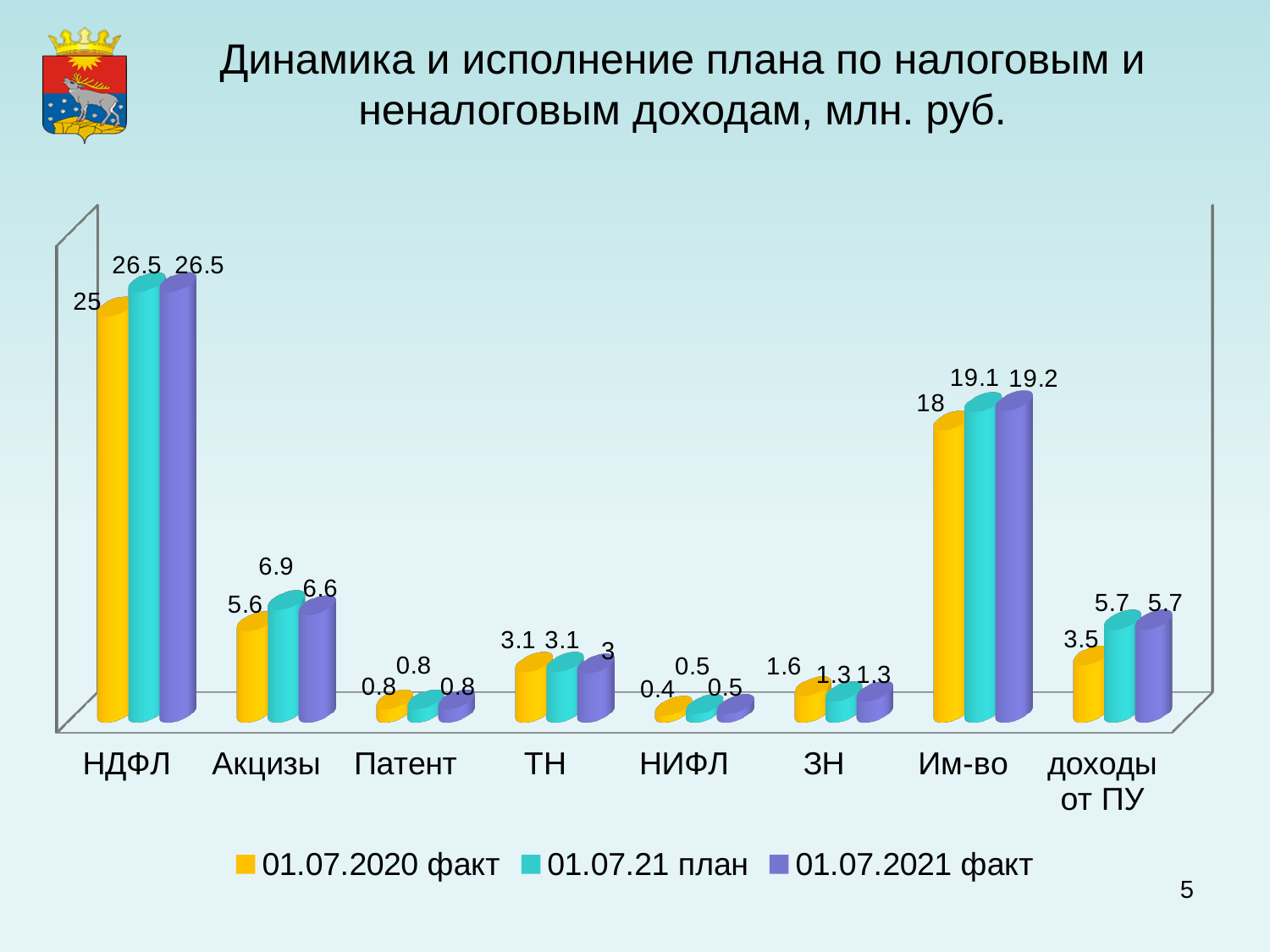
How many categories are shown on the x axis? 8 What is the value for Акцизы in the 01.07.21 план series? 6.9 How many series does the legend list? 3 Which is larger for ЗН: the 01.07.2020 факт value or the 01.07.2021 факт value? 01.07.2020 факт Which category has the highest value in the 01.07.2021 факт series? НДФЛ What is the value for доходы от ПУ in the 01.07.2020 факт series? 3.5 What kind of chart is shown on the slide? Bar chart Which category has the lowest value in the 01.07.2020 факт series? НИФЛ What is the difference between the 01.07.2021 факт and 01.07.2020 факт values for доходы от ПУ? 2.2 What is the value for Им-во in the 01.07.2021 факт series? 19.2 What is the value for НДФЛ in the 01.07.2020 факт series? 25 What is the title of the chart? Динамика и исполнение плана по налоговым и неналоговым доходам, млн. руб.